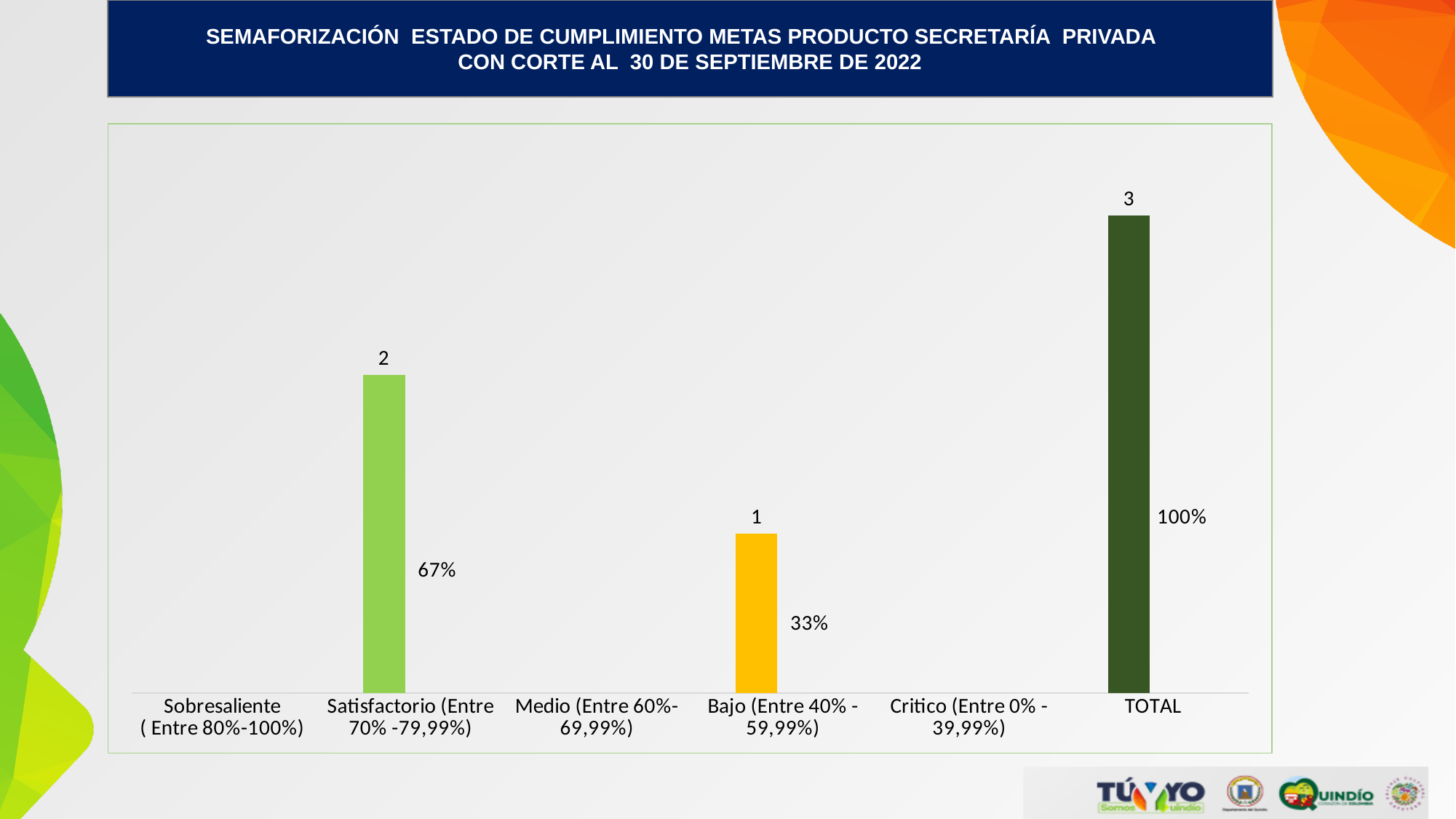
What percentage label is shown next to the Bajo bar? 33% What kind of chart is shown on the slide? Bar chart Which category has the highest bar? TOTAL What is the value shown for the Satisfactorio (Entre 70% -79,99%) category? 2 What is the value shown for the TOTAL category? 3 What is the difference between the TOTAL value and the Satisfactorio value? 1 What is the value shown for the Bajo (Entre 40% - 59,99%) category? 1 What colour is the Bajo (Entre 40% - 59,99%) bar? Orange/yellow How many categories are shown on the x axis? 6 Excluding TOTAL, which category has the highest bar? Satisfactorio (Entre 70% -79,99%) What percentage label is shown next to the Satisfactorio bar? 67% Which is larger, the value for Satisfactorio or the value for Bajo? Satisfactorio